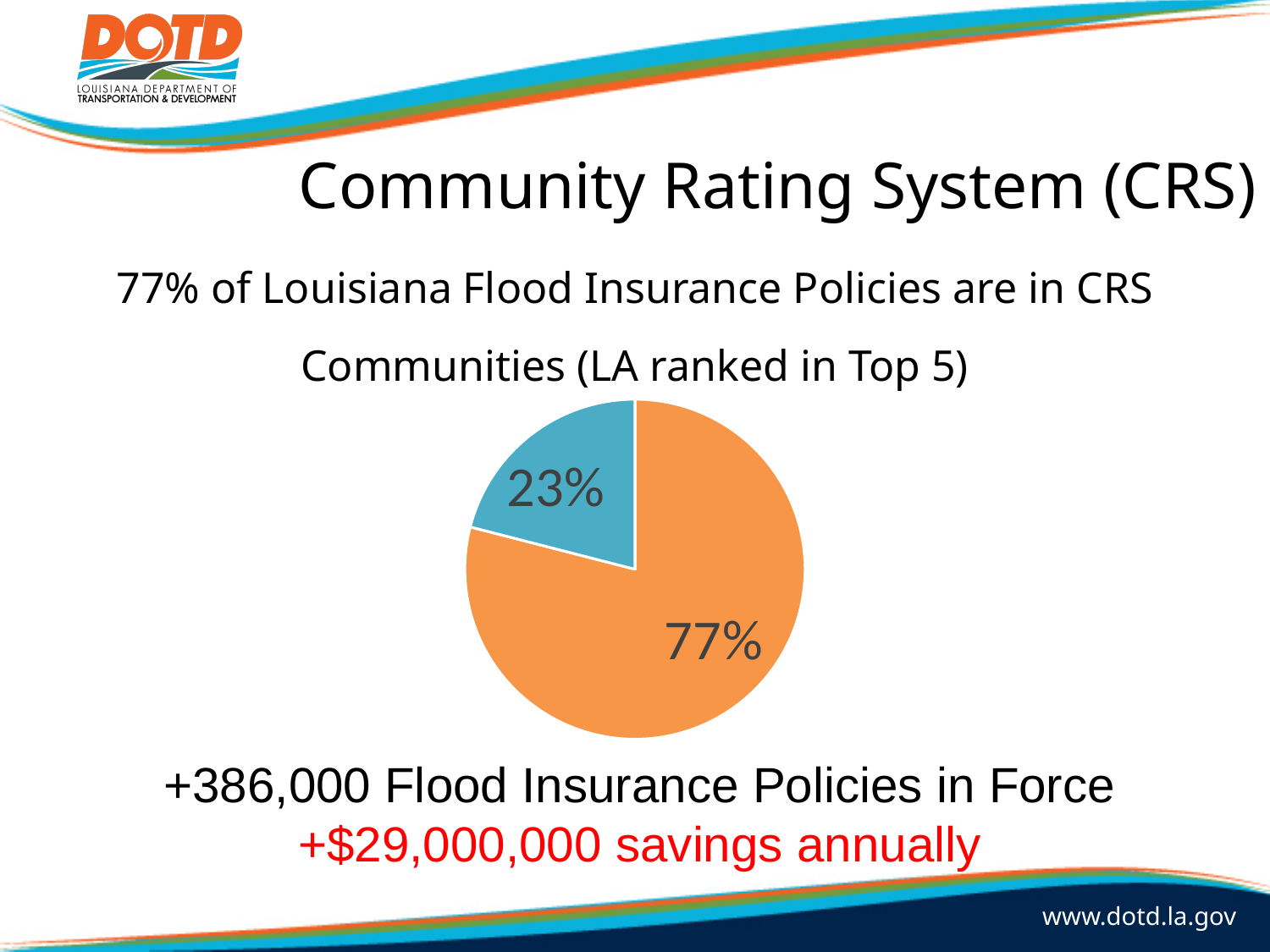
How many slices does the pie chart have? 2 What kind of chart is shown on the slide? pie chart What do the two slice percentages add up to? 100% What percentage is shown on the blue slice of the pie chart? 23% Which slice of the pie chart is the smallest? the blue slice (23%) Which is larger, the orange slice or the blue slice? the orange slice What percentage is shown on the orange slice of the pie chart? 77% Which slice of the pie chart is the largest? the orange slice (77%) What is the difference in percentage points between the orange slice and the blue slice? 54 percentage points Is the blue slice greater or less than 50% of the pie? less What two colours are used for the slices of the pie chart? orange and blue What share of the pie does the orange slice represent? 77%